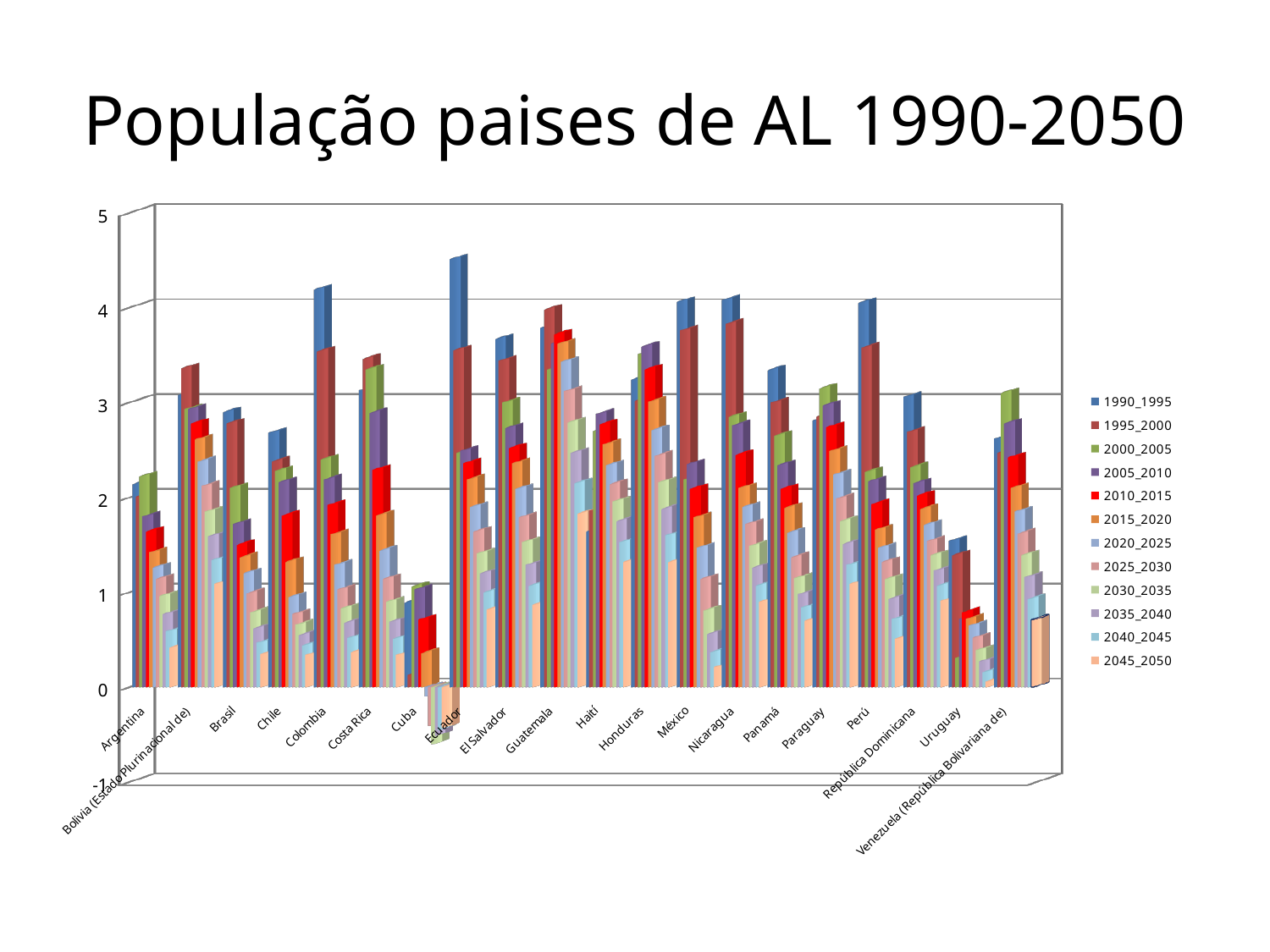
Which country has the lowest value for the 1990_1995 series? Cuba What is the title of the chart? População paises de AL 1990-2050 Is the value for Ecuador in the 2045_2050 series greater or less than 0? greater Which is larger for the 1990_1995 series: Colombia or Chile? Colombia How many countries are shown on the x axis of the chart? 20 What kind of chart is shown on the slide? bar chart Is the value for Uruguay in the 1990_1995 series greater or less than 2? less Which country has the highest value for the 1990_1995 series? Ecuador For Ecuador, do the values rise or fall from the 1990_1995 series to the 2045_2050 series? fall Is the value for Chile in the 1990_1995 series greater or less than 2? greater How many series does the legend list? 12